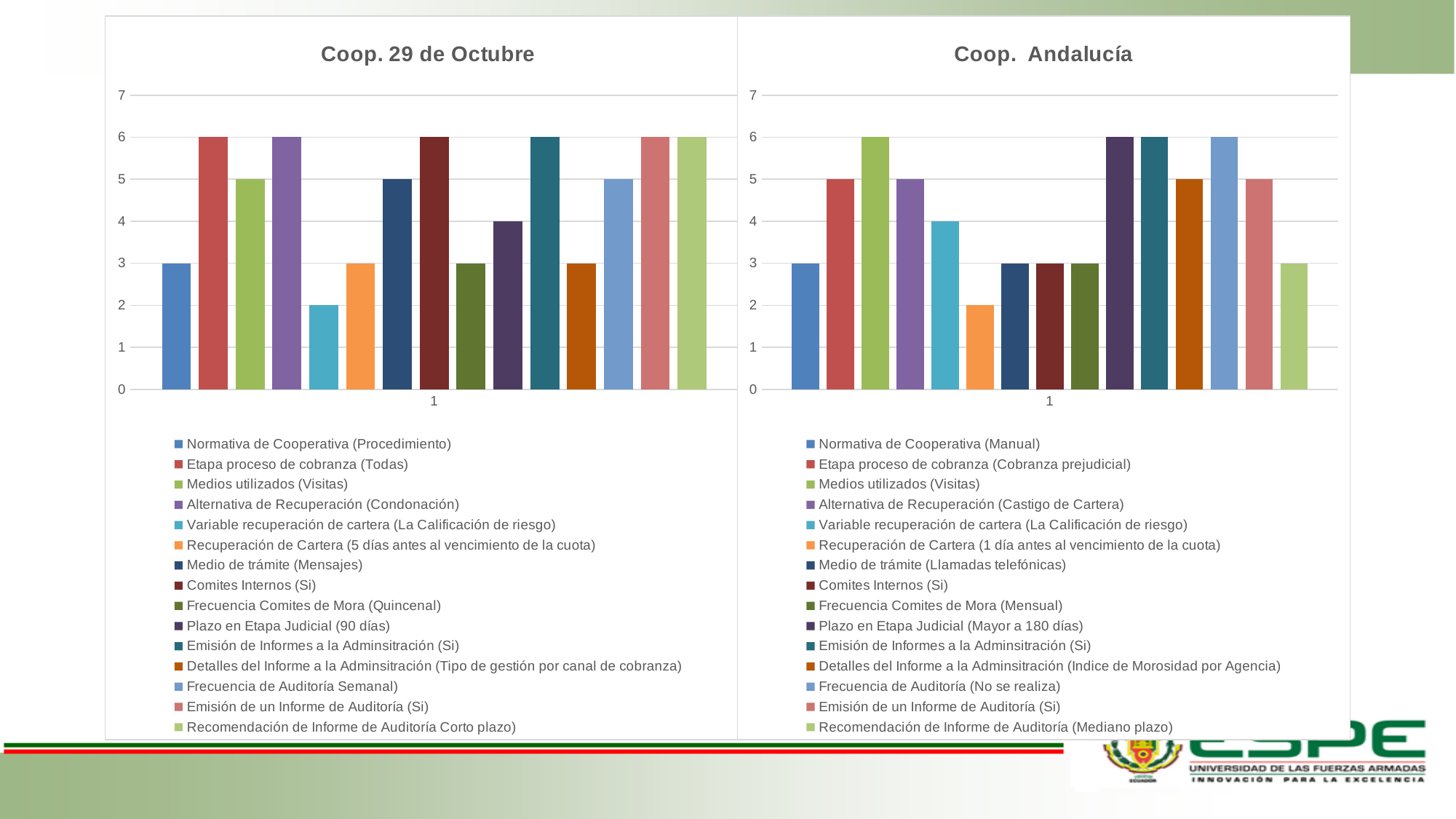
In the Coop. Andalucía chart, which is larger: Medios utilizados (Visitas) or Medio de trámite (Llamadas telefónicas)? Medios utilizados (Visitas) What is the title of the chart on the left side of the slide? Coop. 29 de Octubre In the Coop. Andalucía chart, what is the value for Variable recuperación de cartera (La Calificación de riesgo)? 4 In the Coop. 29 de Octubre chart, what is the difference between Etapa proceso de cobranza (Todas) and Normativa de Cooperativa (Procedimiento)? 3 What kind of chart is the Coop. Andalucía chart? Bar chart In the Coop. Andalucía chart, what is the value for Recuperación de Cartera (1 día antes al vencimiento de la cuota)? 2 In the Coop. Andalucía chart, which series has the lowest value? Recuperación de Cartera (1 día antes al vencimiento de la cuota) In the Coop. 29 de Octubre chart, which series has the lowest value? Variable recuperación de cartera (La Calificación de riesgo) How many series does the legend of the Coop. 29 de Octubre chart list? 15 In the Coop. 29 de Octubre chart, what is the value for Plazo en Etapa Judicial (90 días)? 4 In the Coop. Andalucía chart, what is the difference between Plazo en Etapa Judicial (Mayor a 180 días) and Frecuencia Comites de Mora (Mensual)? 3 In the Coop. 29 de Octubre chart, what is the value for Variable recuperación de cartera (La Calificación de riesgo)? 2